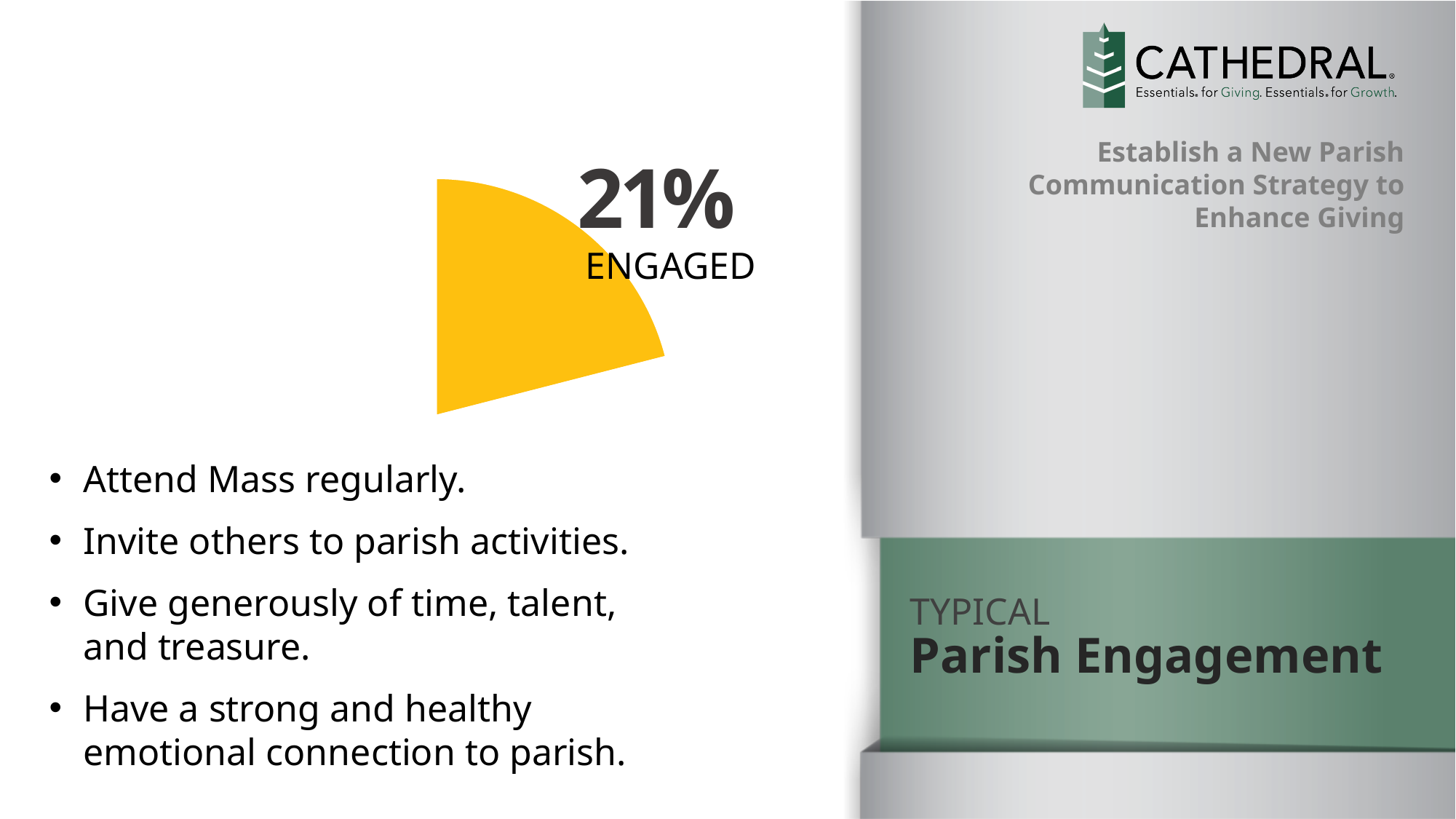
What share of the pie does the yellow slice represent? 21% What label is printed next to the 21% value on the chart? ENGAGED Is the engaged share shown on the chart greater or less than 50%? less What kind of chart is shown on the slide? pie chart What percentage of parishioners does the chart show as engaged? 21% What colour is the slice shown in the chart? yellow